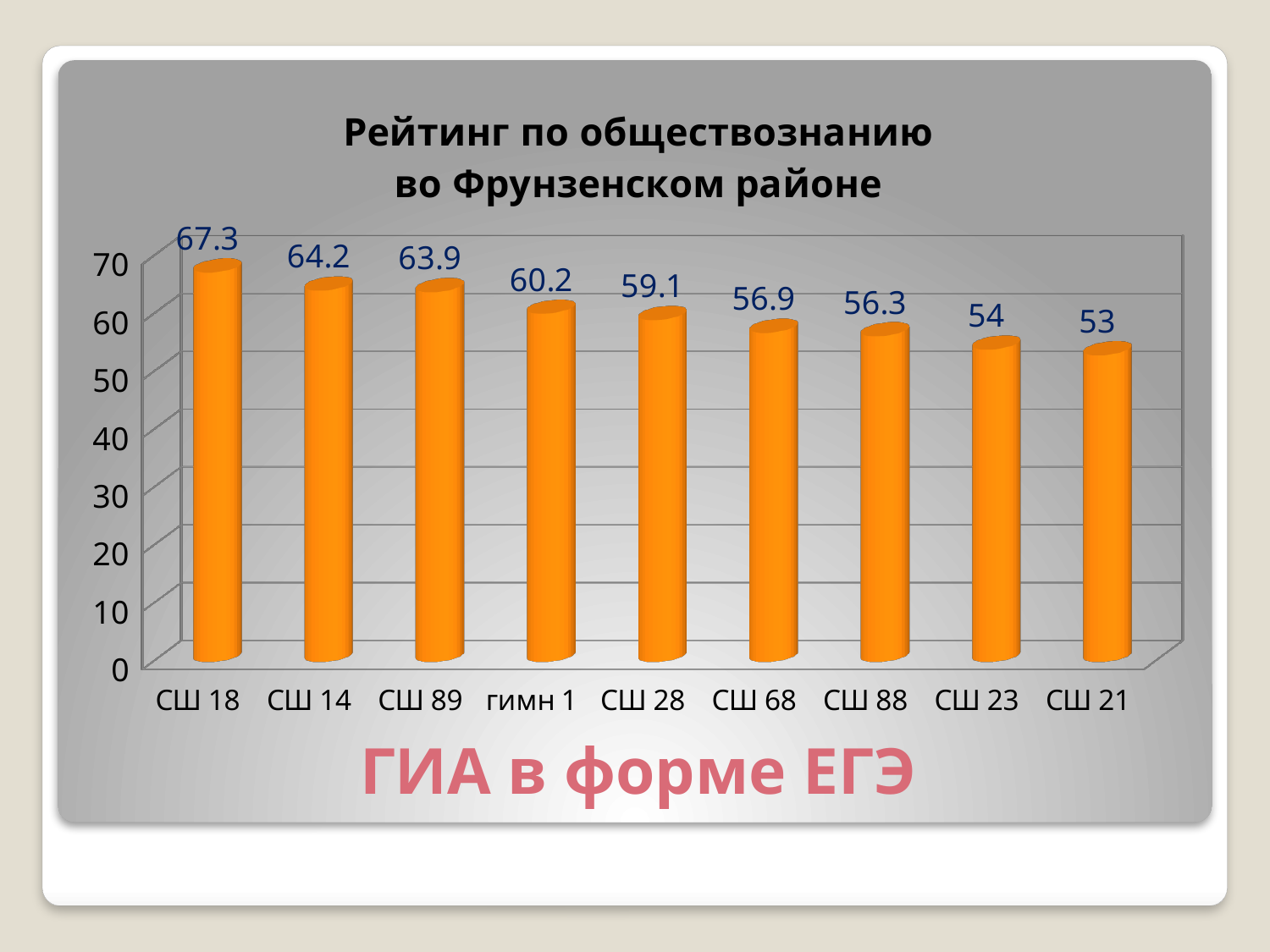
What kind of chart is shown on the slide? bar chart How many schools are shown on the chart? 9 What is the difference between the values for СШ 14 and СШ 89? 0.3 What is the value for СШ 18? 67.3 What is the difference between the values for СШ 18 and СШ 21? 14.3 Do the values rise or fall from left to right along the x axis? fall Which school has the lowest value? СШ 21 What is the value for гимн 1? 60.2 Is the value for СШ 23 greater or less than 50? greater What is the value for СШ 88? 56.3 Which school has the highest value? СШ 18 Which is larger, the value for СШ 28 or the value for СШ 68? СШ 28